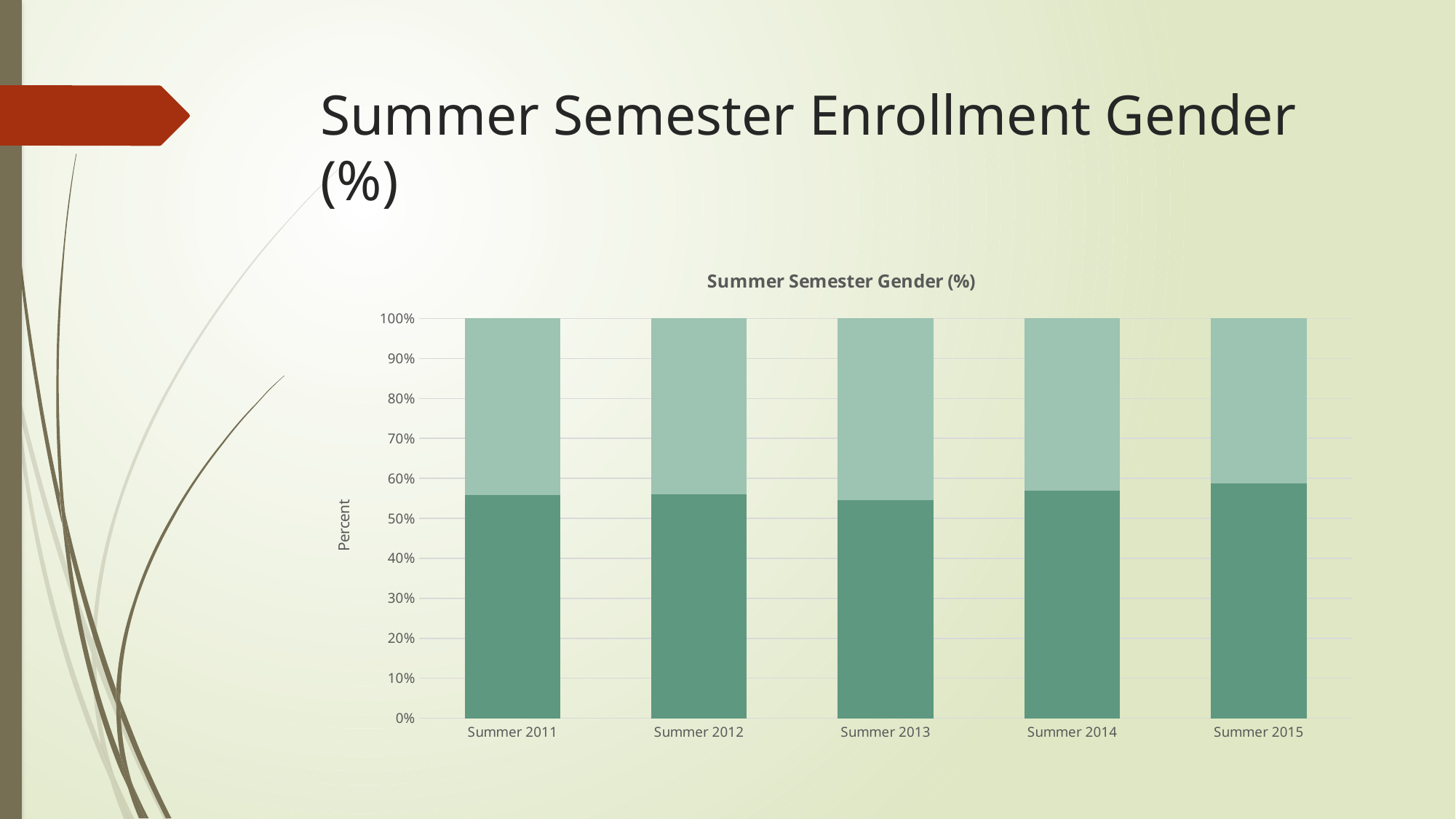
Which summer semester has the smallest dark green (bottom) segment? Summer 2013 Is the dark green (bottom) segment larger for Summer 2015 or for Summer 2013? Summer 2015 What is the title of the chart? Summer Semester Gender (%) Is the dark green (bottom) segment for Summer 2013 greater or less than 60%? less From Summer 2013 to Summer 2015, does the dark green (bottom) segment rise or fall? rise What kind of chart is shown on the slide? stacked bar chart Which summer semester has the largest dark green (bottom) segment? Summer 2015 How many summer semesters are shown on the x axis of the chart? 5 What is the label on the vertical axis of the chart? Percent Is the dark green (bottom) segment for Summer 2011 greater or less than 50%? greater Is the dark green (bottom) segment for Summer 2015 greater or less than 50%? greater